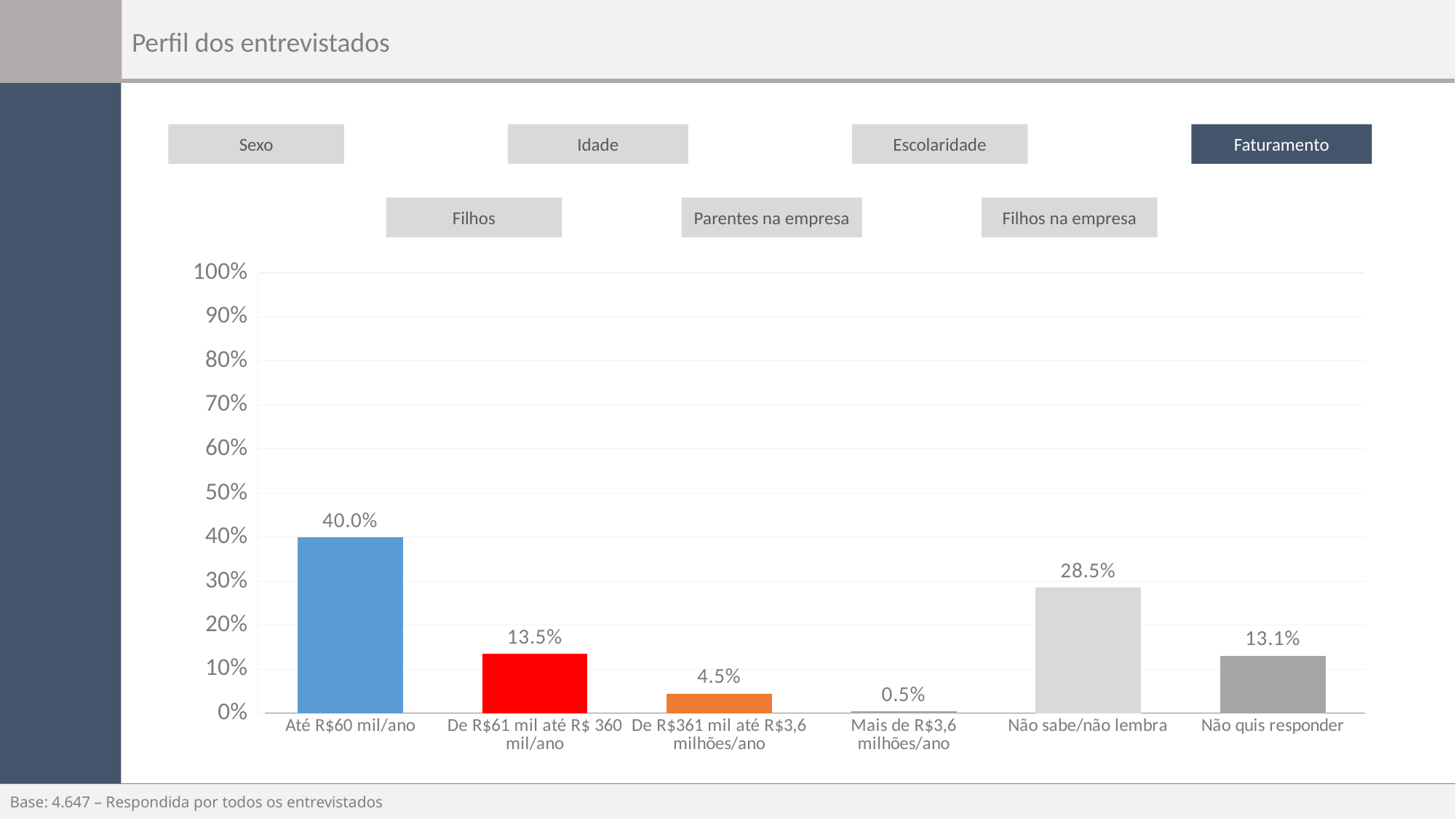
What is the value for 'Não quis responder'? 13.1% Which category has the lowest value? Mais de R$3,6 milhões/ano Is the value for 'Não sabe/não lembra' greater or less than 30%? less Which tab above the chart is highlighted in dark blue? Faturamento How many categories are shown on the x axis? 6 What kind of chart is shown on the slide? bar chart What is the value for 'Não sabe/não lembra'? 28.5% What is the value for 'De R$361 mil até R$3,6 milhões/ano'? 4.5% Which is larger, the value for 'De R$61 mil até R$ 360 mil/ano' or 'Não quis responder'? De R$61 mil até R$ 360 mil/ano What is the value for 'Até R$60 mil/ano'? 40.0% Which category has the highest value? Até R$60 mil/ano What is the difference between the values for 'Até R$60 mil/ano' and 'Não sabe/não lembra'? 11.5%